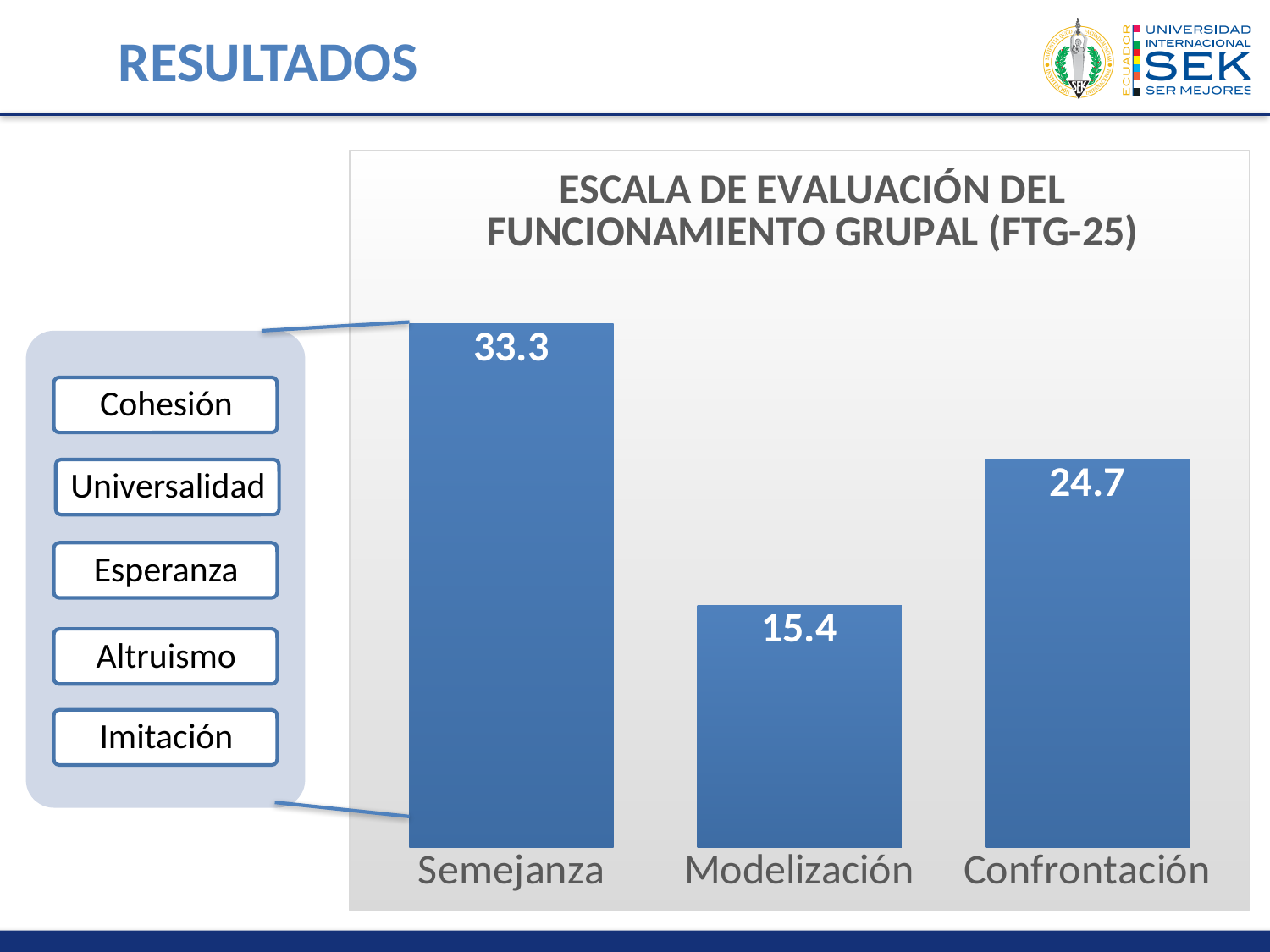
What kind of chart is shown on the slide? Bar chart How many categories are shown in the chart? 3 What is the difference between the values for Semejanza and Modelización? 17.9 Which category has the lowest value? Modelización Which category has the highest value? Semejanza What is the title of the chart? ESCALA DE EVALUACIÓN DEL FUNCIONAMIENTO GRUPAL (FTG-25) What is the value for Confrontación? 24.7 What is the difference between the values for Confrontación and Modelización? 9.3 Which is larger, the value for Confrontación or the value for Modelización? Confrontación What is the value for Semejanza? 33.3 What is the difference between the values for Semejanza and Confrontación? 8.6 What is the value for Modelización? 15.4